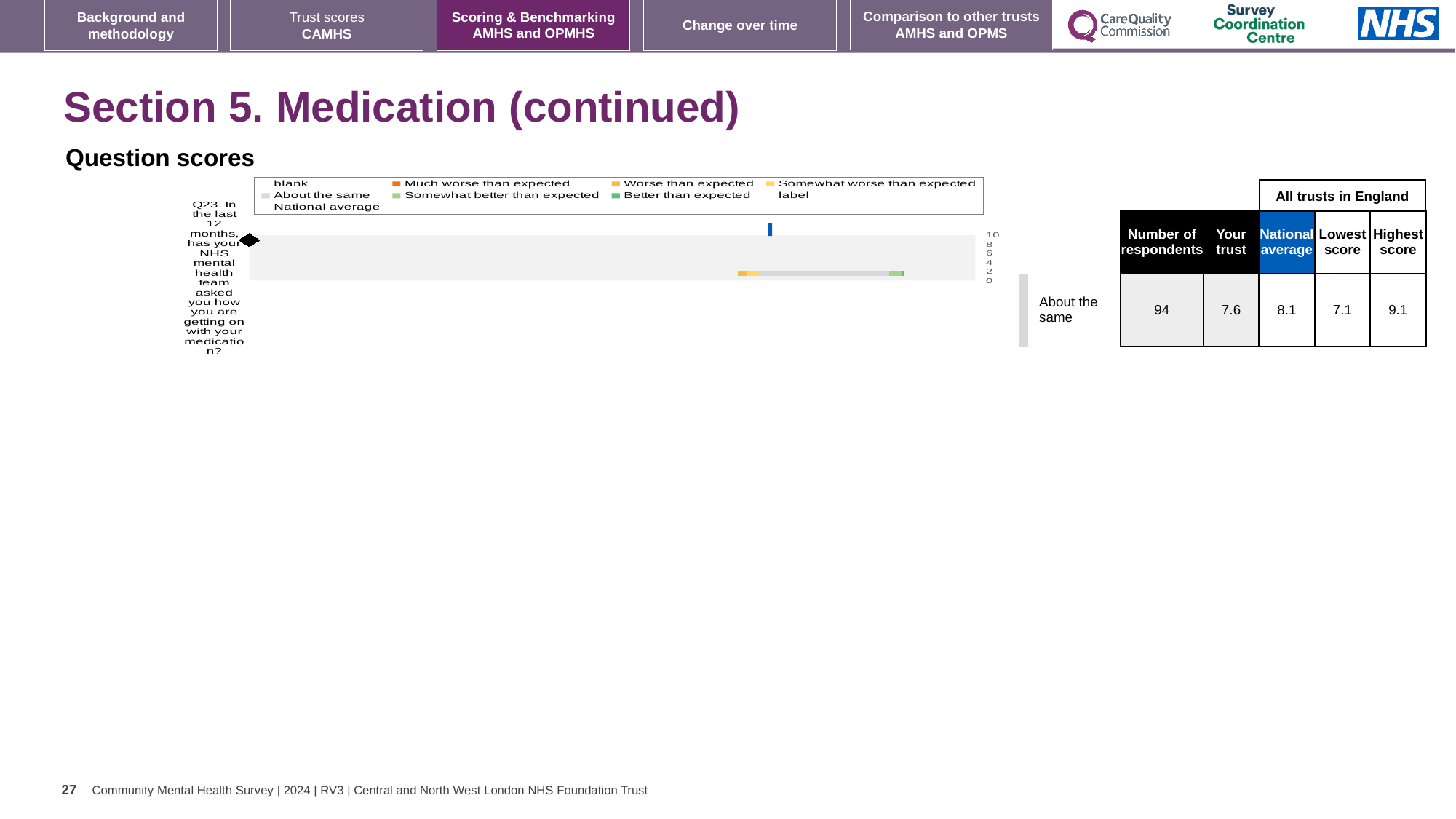
Is the 'Your trust' score for Q23 greater or less than 8? less What is the highest score among all trusts in England for Q23? 9.1 What is the difference between the highest score and the lowest score for Q23? 2.0 How many survey questions are plotted in the Question scores chart? 1 What benchmark category is shown for Q23 next to the chart? About the same What is the lowest score among all trusts in England for Q23? 7.1 What is the national average score for Q23? 8.1 How many respondents answered Q23? 94 Which question number is plotted in the Question scores chart? Q23 What kind of chart is shown under 'Question scores'? bar chart For Q23, which is larger: the 'Your trust' score or the national average? National average What is the 'Your trust' score for Q23? 7.6